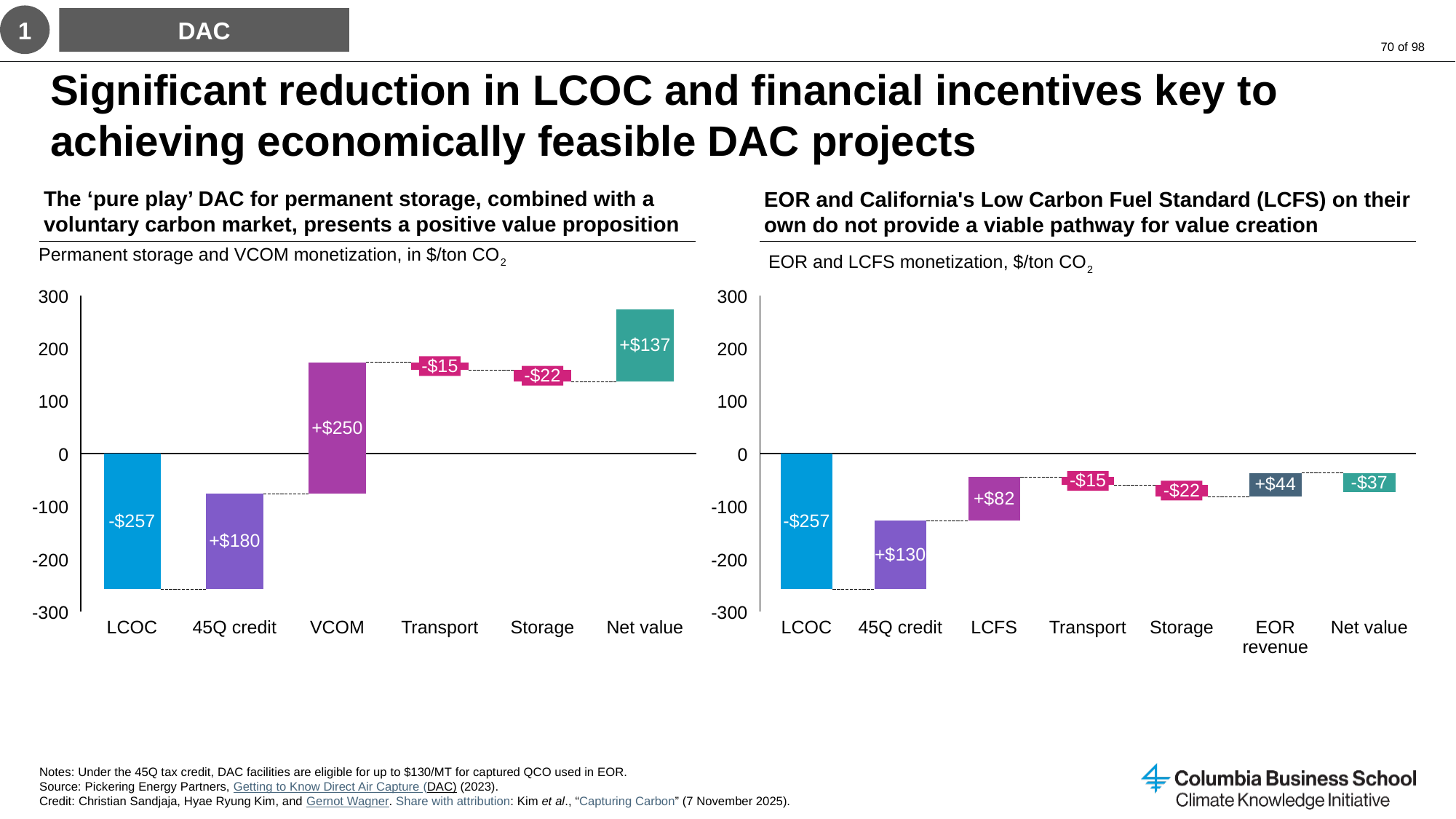
In the left chart (Permanent storage and VCOM monetization), what is the value labelled for VCOM? +$250 In the right chart (EOR and LCFS monetization), which is larger in magnitude: the LCFS value or the EOR revenue value? LCFS In the right chart (EOR and LCFS monetization), what is the value labelled for the 45Q credit? +$130 In the left chart (Permanent storage and VCOM monetization), what is the Net value? +$137 In the left chart (Permanent storage and VCOM monetization), which category has the largest positive value? VCOM In the right chart (EOR and LCFS monetization), what is the Net value? -$37 In the right chart (EOR and LCFS monetization), which category has the most negative value? LCOC How many categories are shown on the x axis of the left chart (Permanent storage and VCOM monetization)? 6 In the right chart (EOR and LCFS monetization), what is the value labelled for EOR revenue? +$44 What type of chart is used on the left side of the slide (Permanent storage and VCOM monetization)? Bar chart (waterfall) What is the difference between the 45Q credit in the left chart (+$180) and the 45Q credit in the right chart (+$130)? $50 How many categories are shown on the x axis of the right chart (EOR and LCFS monetization)? 7